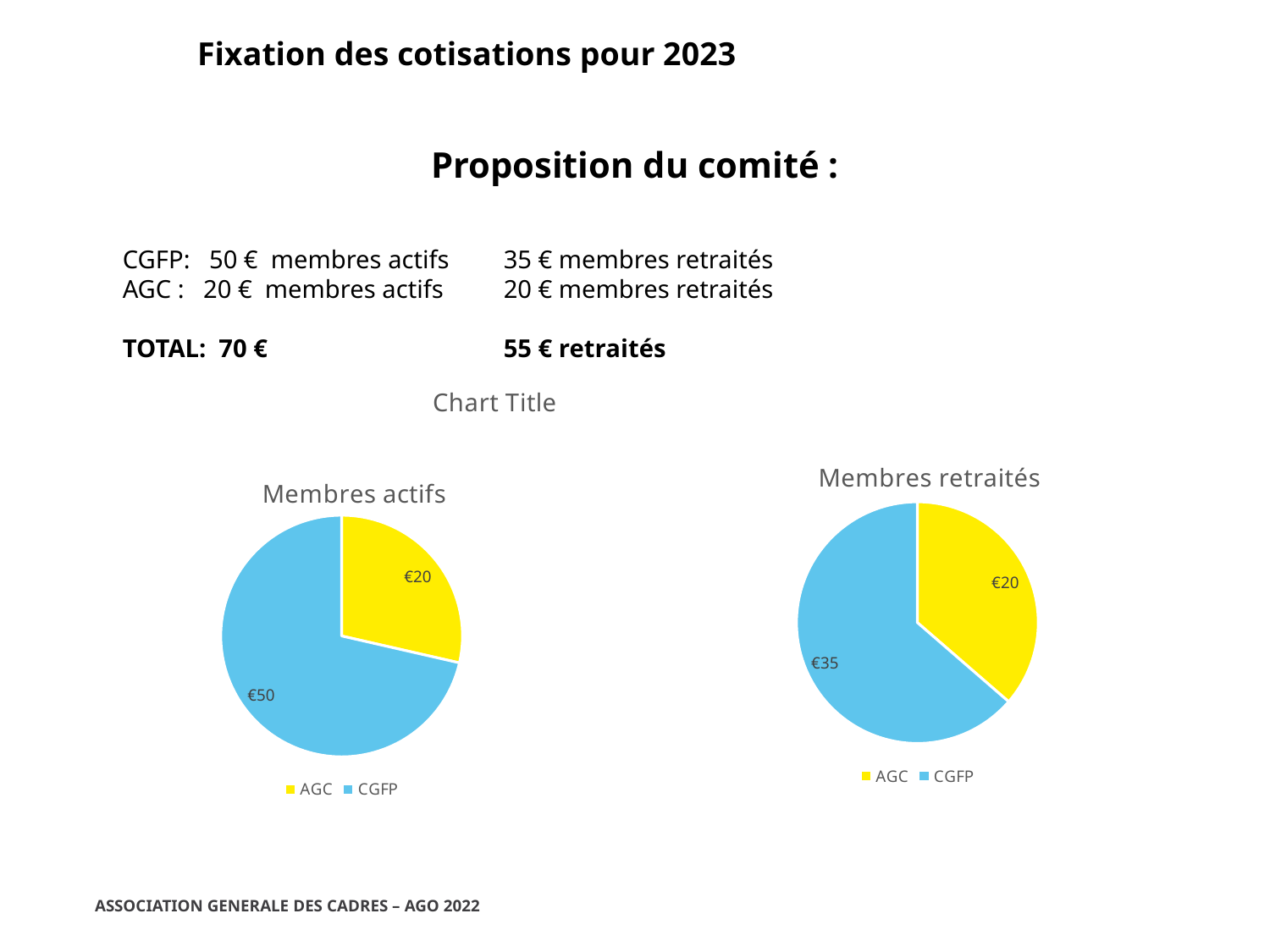
Which entries does the legend of the 'Membres actifs' pie chart list? AGC and CGFP In the 'Membres actifs' pie chart, what is the difference between the CGFP and AGC values? €30 What type of chart is the 'Membres actifs' chart? pie chart In the 'Membres retraités' pie chart, what is the value for CGFP? €35 In the 'Membres actifs' pie chart, what is the value for CGFP? €50 In the 'Membres actifs' pie chart, what is the value for AGC? €20 In the 'Membres actifs' pie chart, which category has the largest slice? CGFP How many categories does the 'Membres retraités' pie chart show? 2 In the 'Membres retraités' pie chart, which category has the smallest slice? AGC In the 'Membres retraités' pie chart, what is the difference between the CGFP and AGC values? €15 In the 'Membres retraités' pie chart, what is the value for AGC? €20 In the 'Membres retraités' pie chart, is the CGFP value larger or smaller than the AGC value? larger